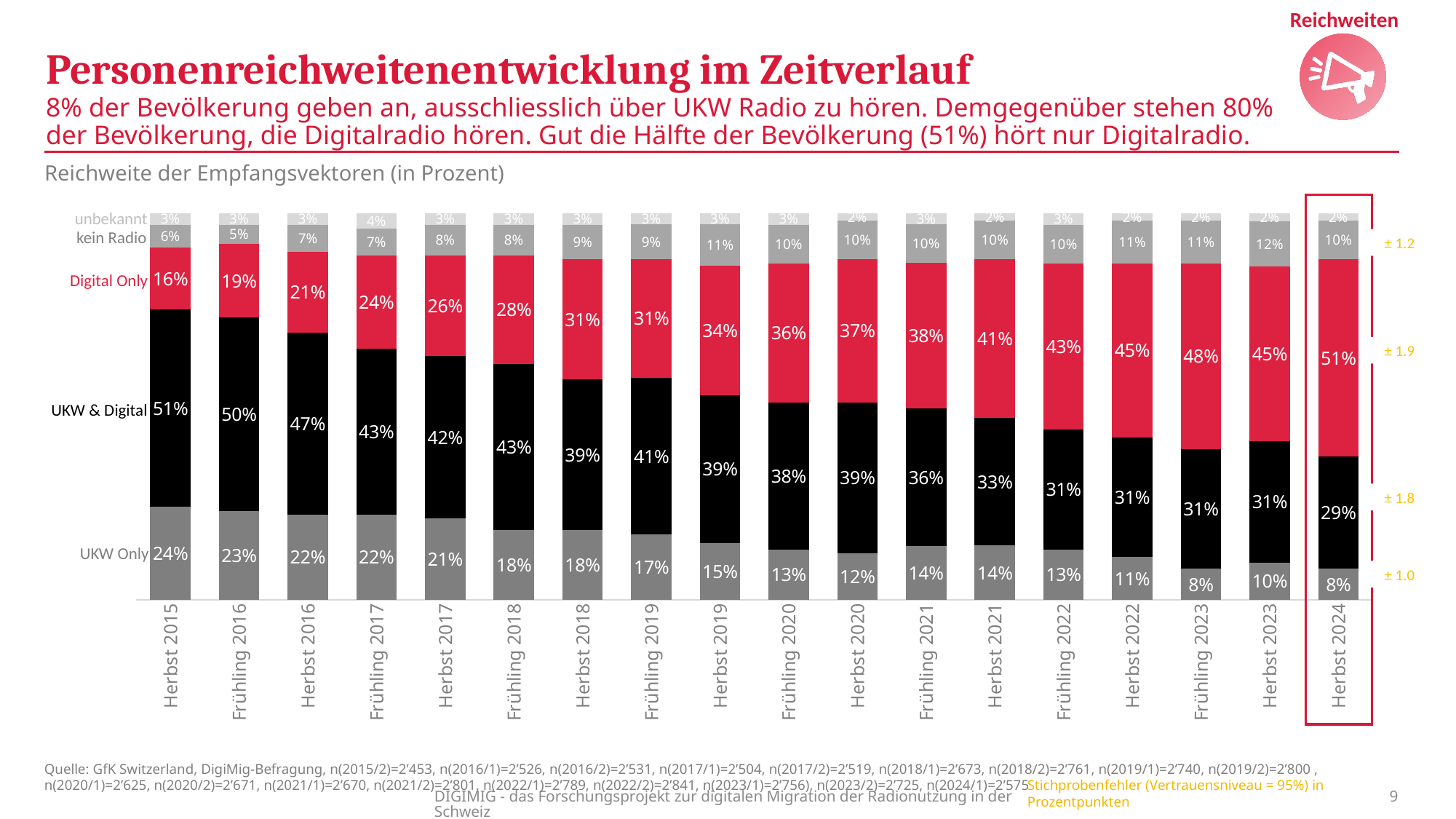
For Herbst 2020, which is larger: UKW & Digital or Digital Only? UKW & Digital What is the kein Radio value for Herbst 2023? 12% In which period is the Digital Only share highest? Herbst 2024 Does the Digital Only share rise or fall from Herbst 2015 to Herbst 2024? Rises How many time periods are shown on the x axis? 18 What is the UKW Only value for Herbst 2015? 24% What kind of chart is shown on the slide? Stacked bar chart What colour represents the Digital Only segment? Red What is the Digital Only value for Herbst 2024? 51% By how many percentage points did the Digital Only share increase from Herbst 2015 to Herbst 2024? 35 percentage points What is the UKW & Digital value for Frühling 2019? 41% In which period is the UKW Only share highest? Herbst 2015